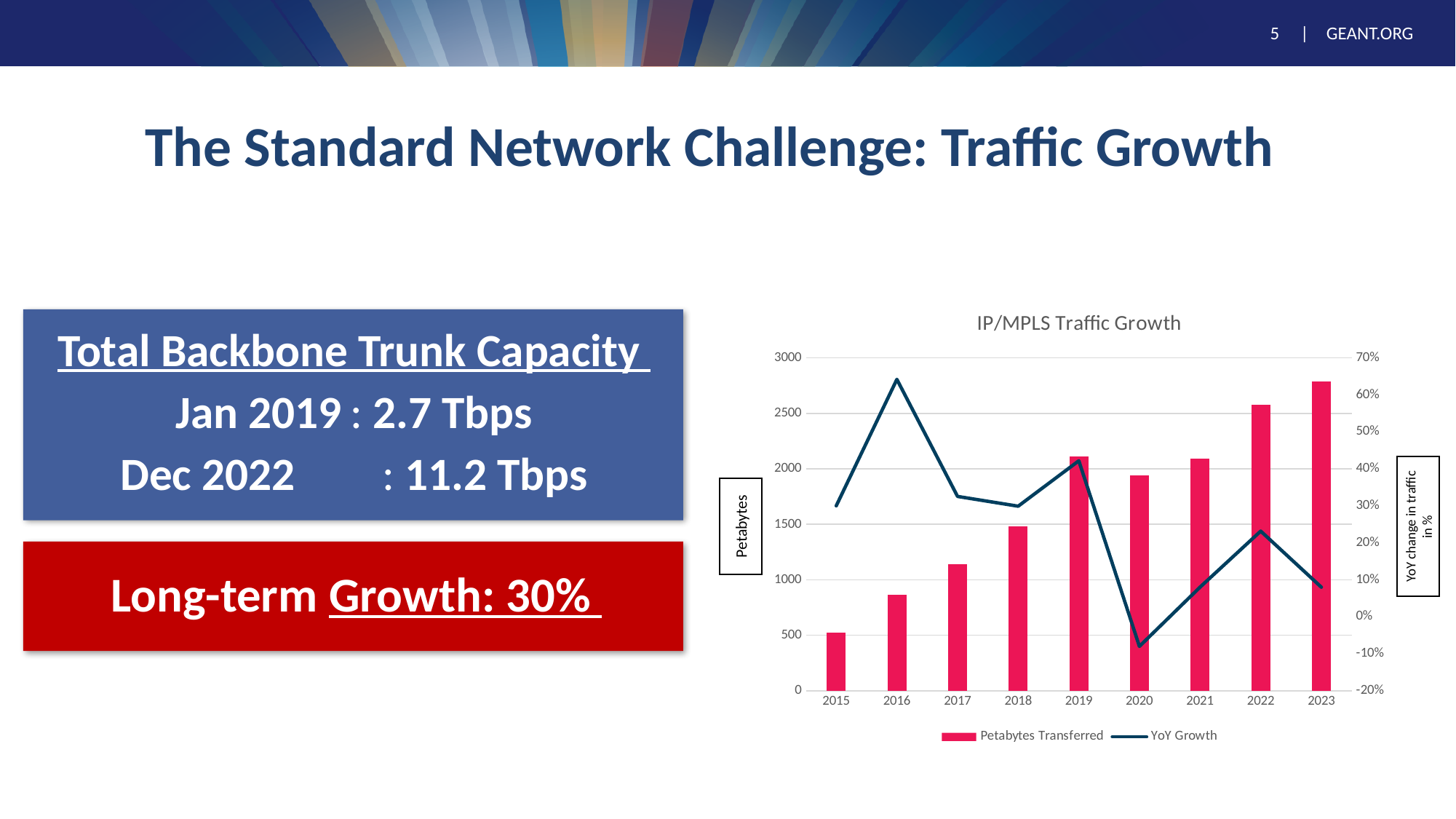
In the IP/MPLS Traffic Growth chart, is the YoY Growth value for 2020 greater or less than 0%? less In the IP/MPLS Traffic Growth chart, is the Petabytes Transferred value for 2016 greater or less than 1000? less What is the label on the left vertical axis of the IP/MPLS Traffic Growth chart? Petabytes In the IP/MPLS Traffic Growth chart, which year has the highest Petabytes Transferred bar? 2023 In the IP/MPLS Traffic Growth chart, which year has the lowest Petabytes Transferred bar? 2015 In the IP/MPLS Traffic Growth chart, which year has the larger Petabytes Transferred bar, 2021 or 2022? 2022 What kind of chart is the IP/MPLS Traffic Growth chart? A combined bar and line chart In the IP/MPLS Traffic Growth chart, which year has the lowest YoY Growth value? 2020 In the IP/MPLS Traffic Growth chart, which year has the highest YoY Growth value? 2016 How many years are shown on the x axis of the IP/MPLS Traffic Growth chart? 9 How many series does the legend of the IP/MPLS Traffic Growth chart list? 2 In the IP/MPLS Traffic Growth chart, is the Petabytes Transferred value for 2022 greater or less than 2500? greater